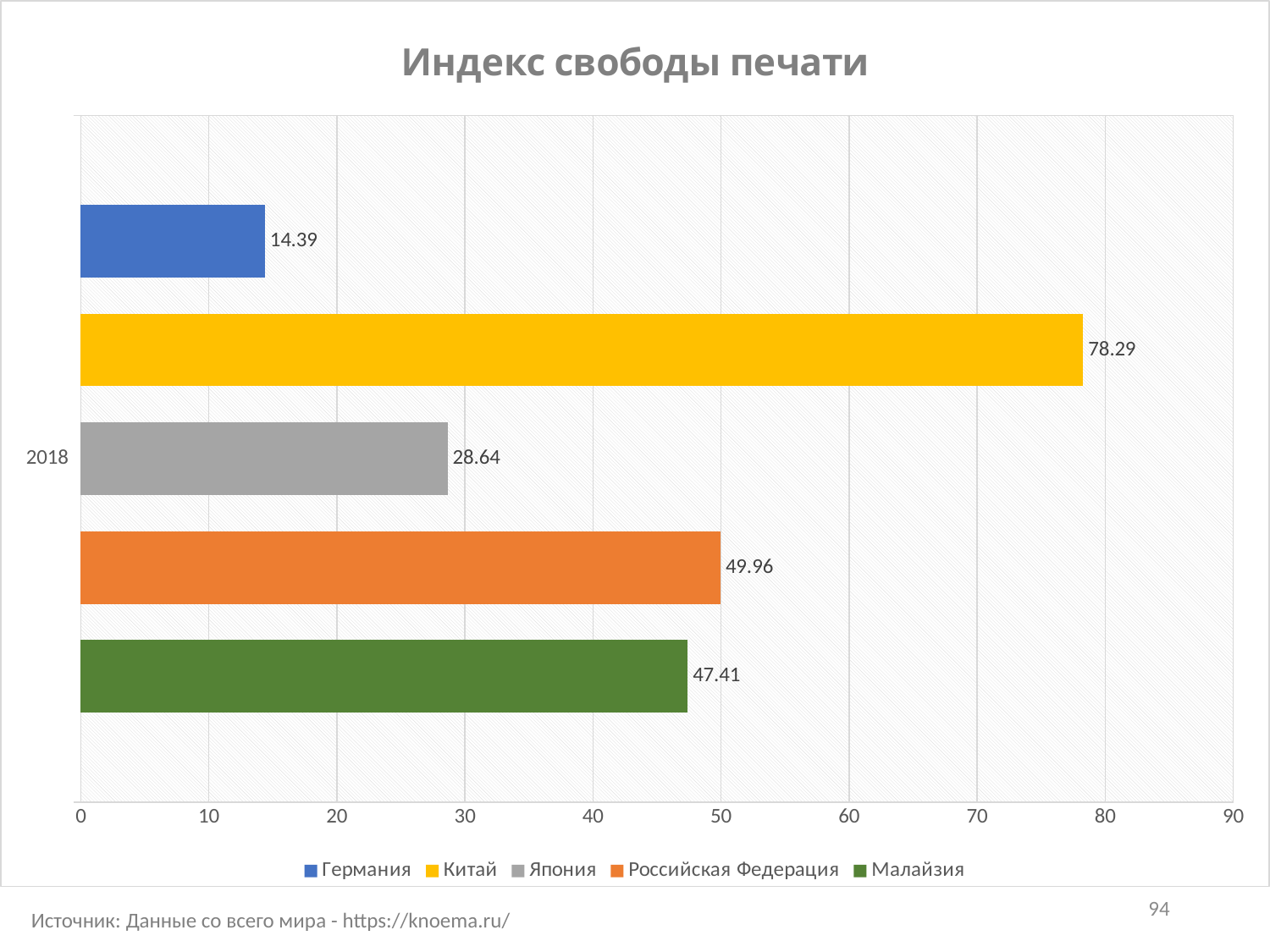
What is the value for Российская Федерация in the chart? 49.96 Which series has the lowest value in the chart? Германия How many series does the legend list? 5 Which series has the highest value in the chart? Китай What kind of chart is shown on the slide? bar chart What is the value for Китай in the chart? 78.29 Is the value for Китай greater or less than 70? greater What is the difference between the values for Китай and Япония? 49.65 What is the value for Германия in the chart? 14.39 Which is larger, the value for Япония or the value for Малайзия? Малайзия What is the title of the chart? Индекс свободы печати What is the difference between the values for Российская Федерация and Малайзия? 2.55